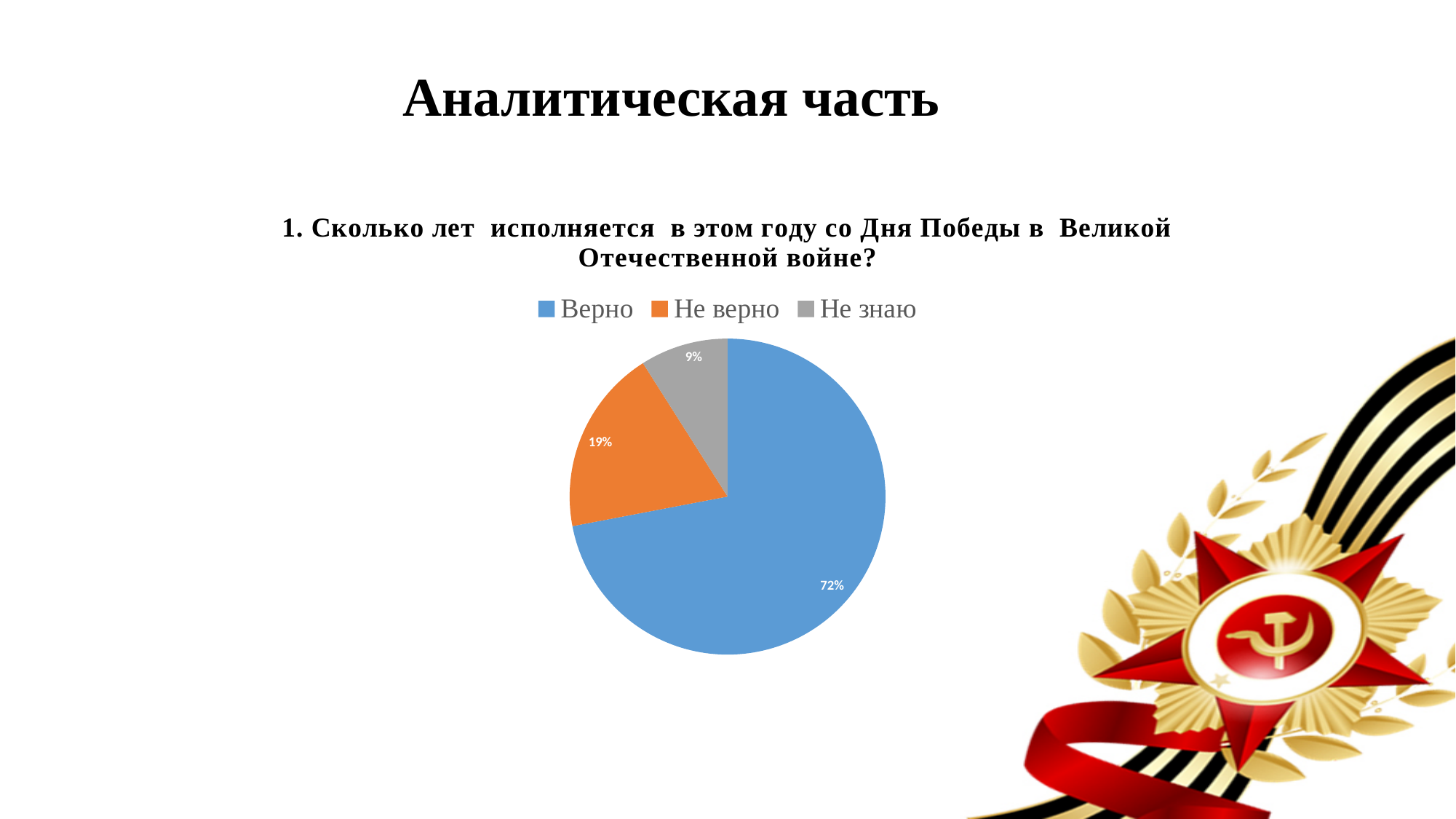
What is the difference in percentage points between "Верно" and "Не верно"? 53 What colour is the slice for "Не верно"? orange Which is larger, the share for "Не верно" or the share for "Не знаю"? Не верно Which category has the smallest share of the pie? Не знаю Which category has the largest share of the pie? Верно What percentage of the pie is labelled "Не знаю"? 9% What percentage of the pie is labelled "Не верно"? 19% What percentage of the pie is labelled "Верно"? 72% How many entries does the legend list? 3 What is the difference in percentage points between "Не верно" and "Не знаю"? 10 What kind of chart is shown on the slide? pie chart How many slices does the pie chart have? 3